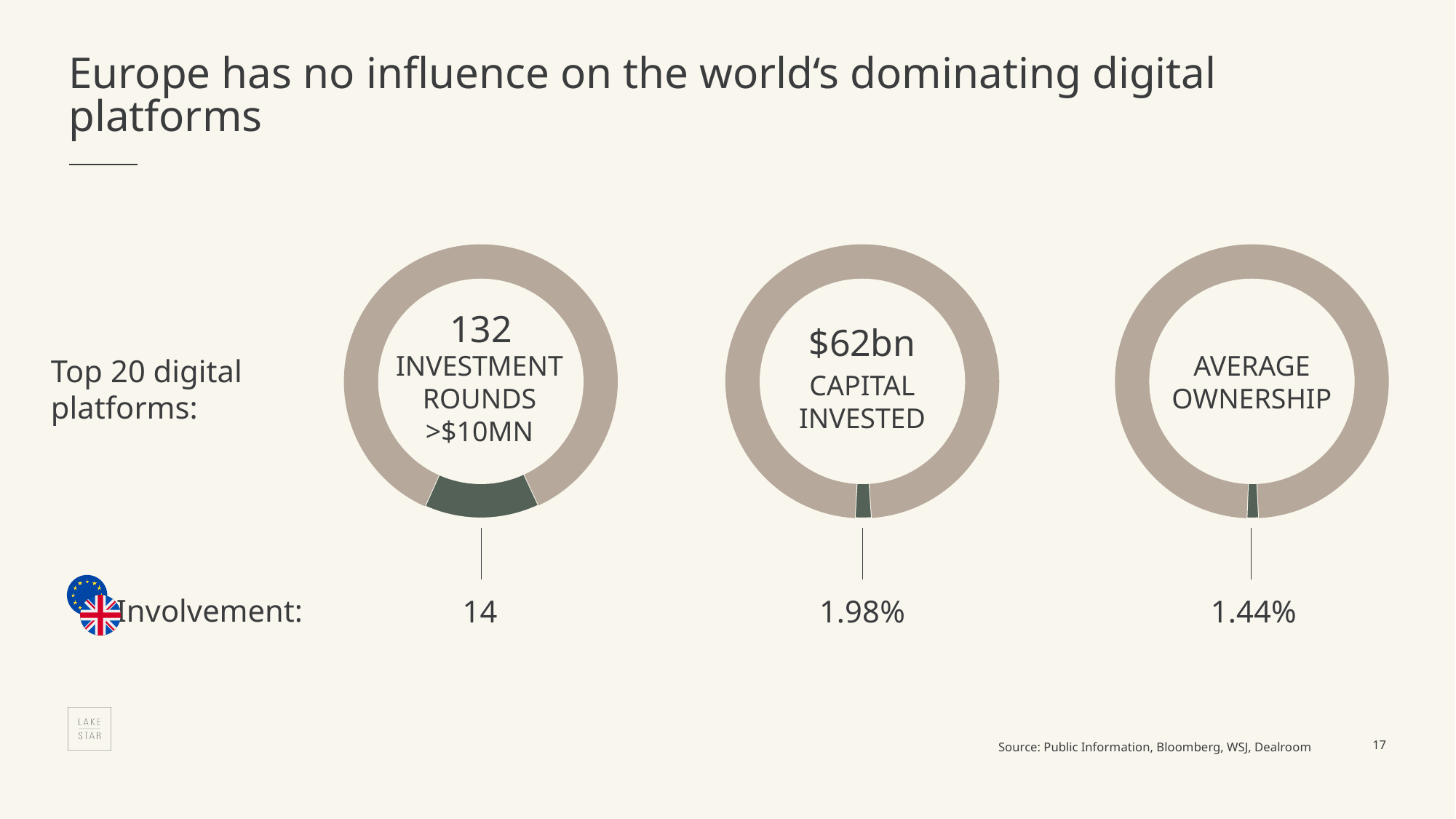
In the middle donut chart (capital invested), what is the European involvement percentage? 1.98% What kind of chart is used to show the three metrics on the slide? Donut (pie) chart What is the difference between the total investment rounds >$10MN (132) and the European involvement (14) in the left donut chart? 118 In the left donut chart (investment rounds >$10MN), what is the European involvement value? 14 Which is larger: the European involvement in capital invested (middle chart) or in average ownership (right chart)? Capital invested (1.98%) In the middle donut chart, how much capital invested is shown for the top 20 digital platforms? $62bn What is the title of the slide containing the three donut charts? Europe has no influence on the world's dominating digital platforms Of the three donut charts, which metric shows the lowest European involvement percentage? Average ownership (1.44%) In the right donut chart (average ownership), what is the European involvement percentage? 1.44% How many donut charts are shown on the slide? 3 What label is written inside the right donut chart? AVERAGE OWNERSHIP In the left donut chart, how many investment rounds >$10MN are shown in total for the top 20 digital platforms? 132